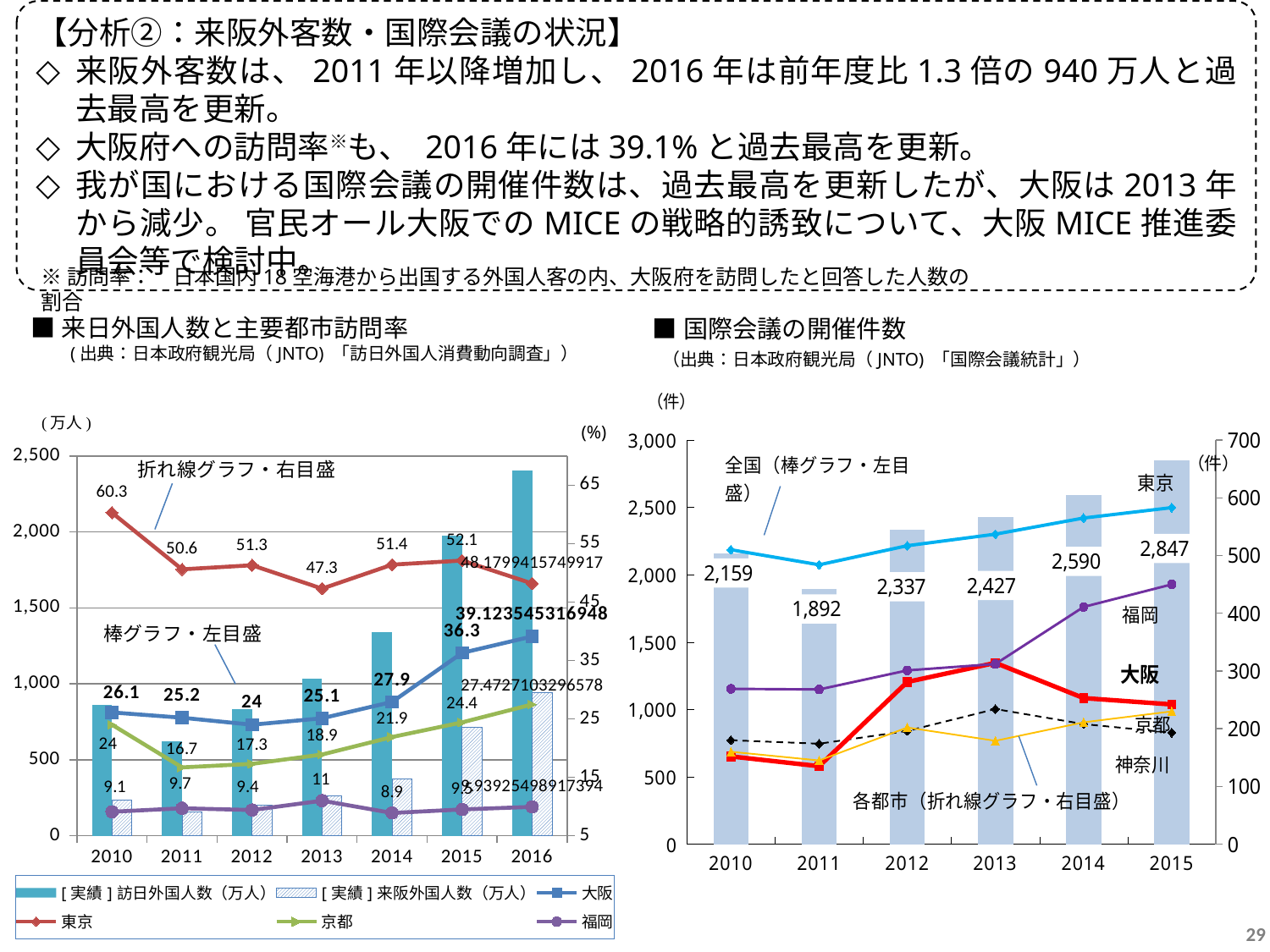
In the 国際会議の開催件数 chart on the right, is the 東京 value for 2015 greater or less than 500? greater In the 国際会議の開催件数 chart on the right, how many years are shown on the x axis? 6 In the 来日外国人数と主要都市訪問率 chart on the left, what is the 大阪 value for 2015? 36.3 In the 来日外国人数と主要都市訪問率 chart on the left, in which year is the 東京 value highest? 2010 In the 国際会議の開催件数 chart on the right, which year has the lowest 全国 value? 2011 In the 国際会議の開催件数 chart on the right, does the 全国 value rise or fall from 2011 to 2015? rise In the 来日外国人数と主要都市訪問率 chart on the left, how many entries does the legend list? 6 In the 国際会議の開催件数 chart on the right, what is the difference between the 全国 values for 2015 and 2010? 688 In the 国際会議の開催件数 chart on the right, what is the 全国 value for 2015? 2,847 In the 来日外国人数と主要都市訪問率 chart on the left, which is larger in 2014, the 大阪 value or the 京都 value? 大阪 In the 来日外国人数と主要都市訪問率 chart on the left, what is the difference between the 大阪 values for 2015 and 2014? 8.4 In the 来日外国人数と主要都市訪問率 chart on the left, what is the 東京 value for 2010? 60.3